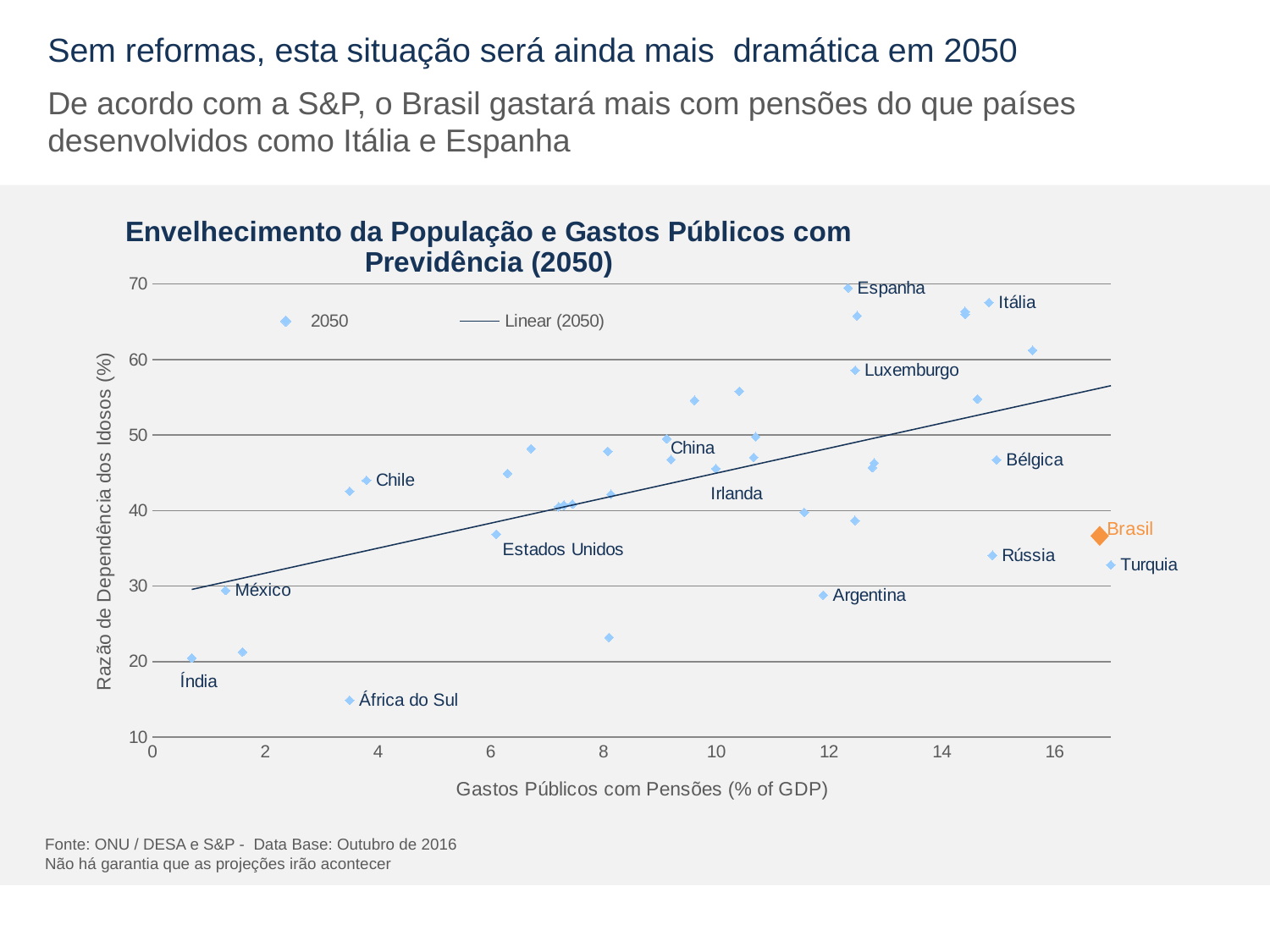
According to the linear trend line, does the old-age dependency ratio rise or fall as public pension spending increases? Rises Is the old-age dependency ratio for Rússia greater or less than 40? less Which labelled country has the highest old-age dependency ratio (Razão de Dependência dos Idosos) in the chart? Espanha Which labelled country has the lowest public pension spending (Gastos Públicos com Pensões) in the chart? Índia How many entries does the chart legend list? 2 Is the public pension spending (% of GDP) for Brasil greater or less than 16? greater Which labelled country has the lowest old-age dependency ratio (Razão de Dependência dos Idosos) in the chart? África do Sul Which has a higher old-age dependency ratio, Brasil or Argentina? Brasil Is the old-age dependency ratio for Luxemburgo greater or less than 50? greater What kind of chart is shown on the slide? Scatter chart What is the title of the chart? Envelhecimento da População e Gastos Públicos com Previdência (2050)